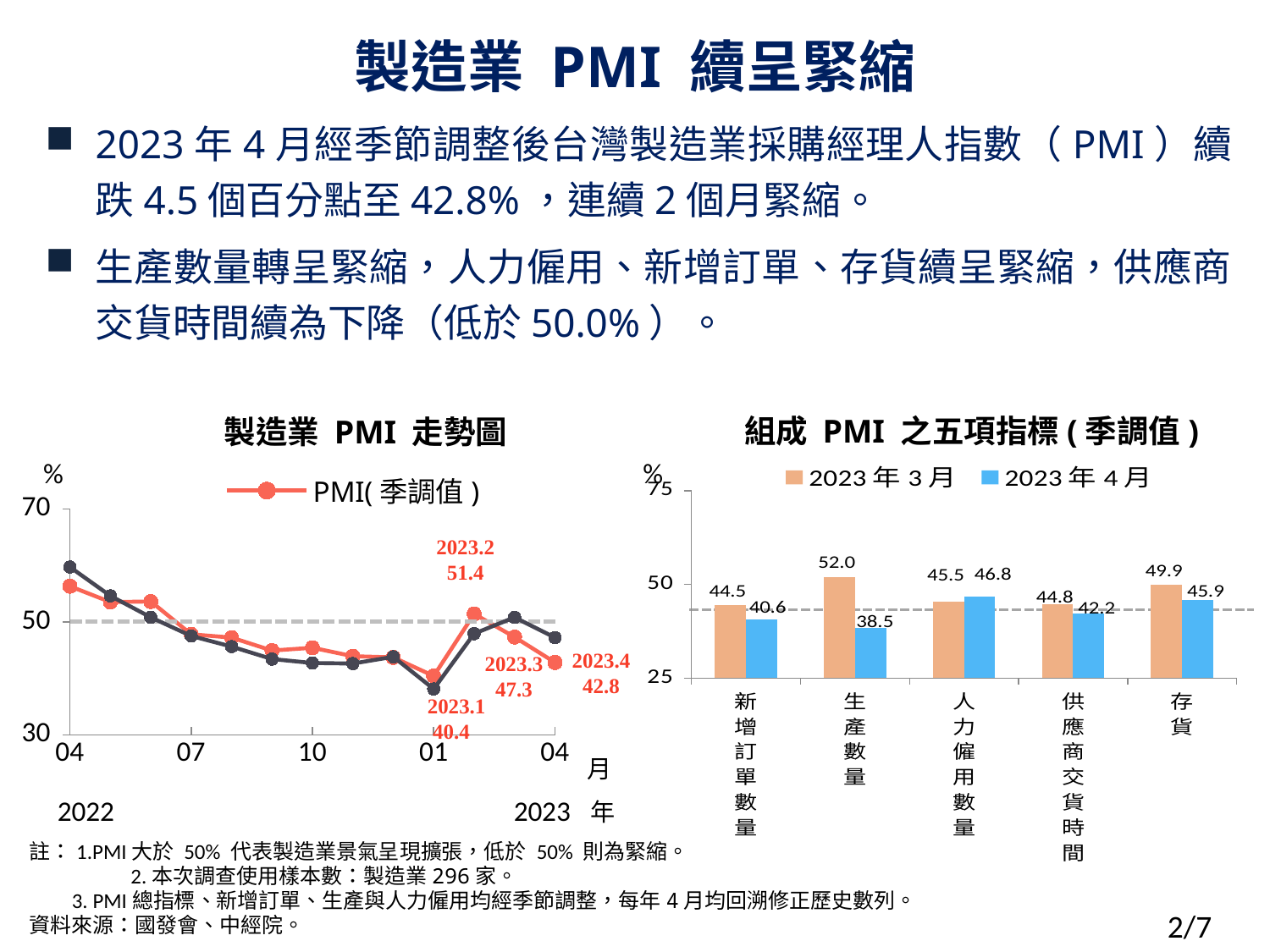
「組成 PMI 之五項指標(季調值)」圖共有幾個類別？ 5 在「製造業 PMI 走勢圖」中，2023年1月的 PMI(季調值) 是多少？ 40.4 在「組成 PMI 之五項指標(季調值)」圖中，2023年4月哪一項指標的數值最高？ 人力僱用數量 在「製造業 PMI 走勢圖」中，PMI(季調值) 從2023年3月到2023年4月下降了多少？ 4.5 在「組成 PMI 之五項指標(季調值)」圖中，人力僱用數量在2023年3月與2023年4月哪一個較高？ 2023年4月 在「組成 PMI 之五項指標(季調值)」圖中，2023年3月存貨的數值是多少？ 49.9 「組成 PMI 之五項指標(季調值)」圖的圖例列出幾個數列？ 2 在「組成 PMI 之五項指標(季調值)」圖中，2023年4月哪一項指標的數值最低？ 生產數量 「組成 PMI 之五項指標(季調值)」是哪一種圖表？ 長條圖 在「製造業 PMI 走勢圖」中，2023年2月的 PMI(季調值) 是多少？ 51.4 在「組成 PMI 之五項指標(季調值)」圖中，生產數量從2023年3月到2023年4月下降了多少？ 13.5 在「組成 PMI 之五項指標(季調值)」圖中，2023年4月生產數量的數值是多少？ 38.5